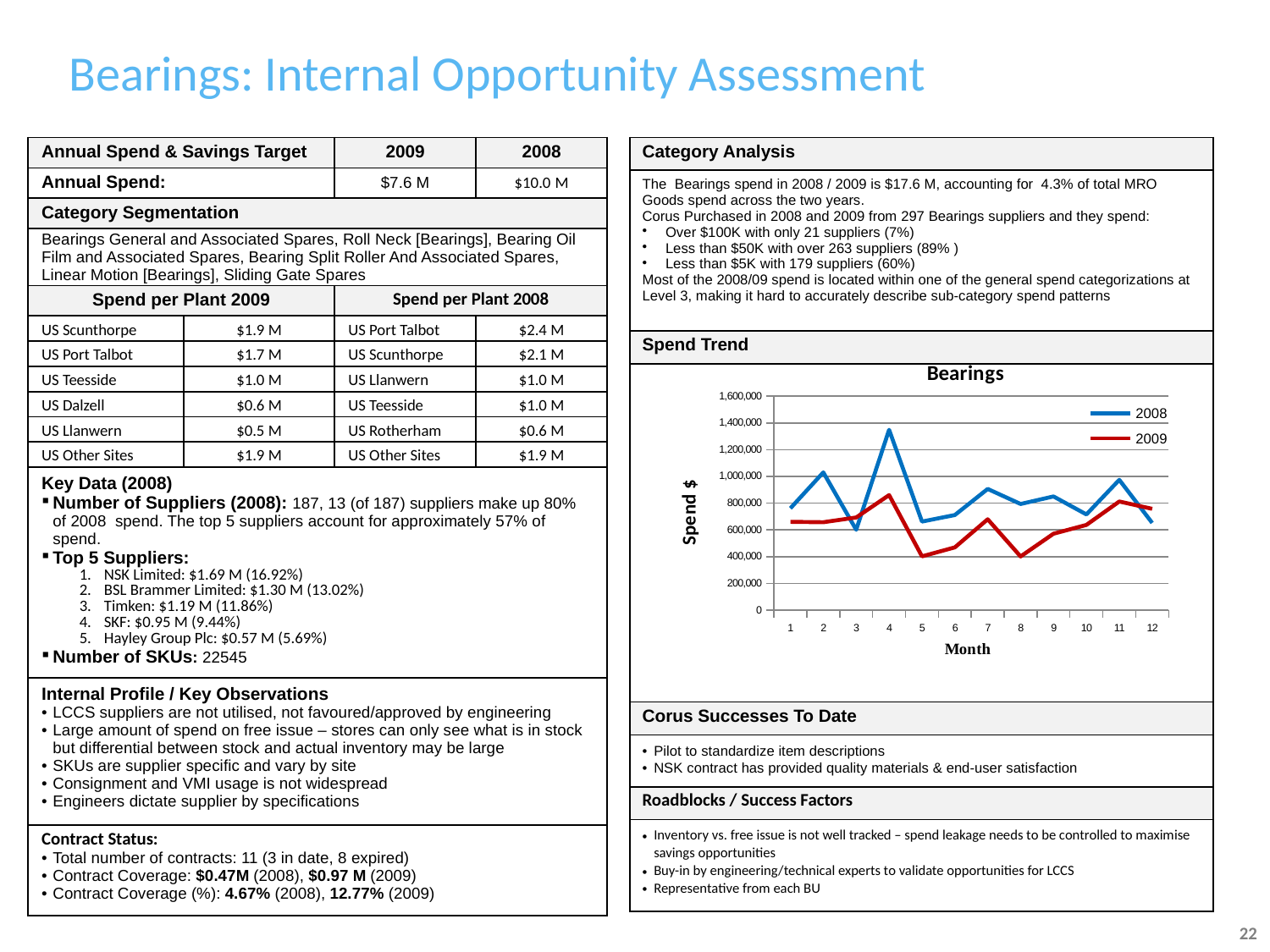
What is the label on the y axis of the Bearings chart? Spend $ How many months are plotted along the x axis of the Bearings chart? 12 How many series does the legend of the Bearings chart list? 2 Which colour represents the 2009 series in the Bearings chart? red Is the 2009 value for month 5 in the Bearings chart greater or less than 600,000? less Is the 2008 value for month 2 in the Bearings chart greater or less than 800,000? greater In month 4 of the Bearings chart, which series has the larger value, 2008 or 2009? 2008 Is the 2008 value for month 4 in the Bearings chart greater or less than 1,200,000? greater In which month does the 2008 series reach its highest value in the Bearings chart? 4 What kind of chart is the Bearings spend trend chart? line chart In month 12 of the Bearings chart, which series has the larger value, 2008 or 2009? 2009